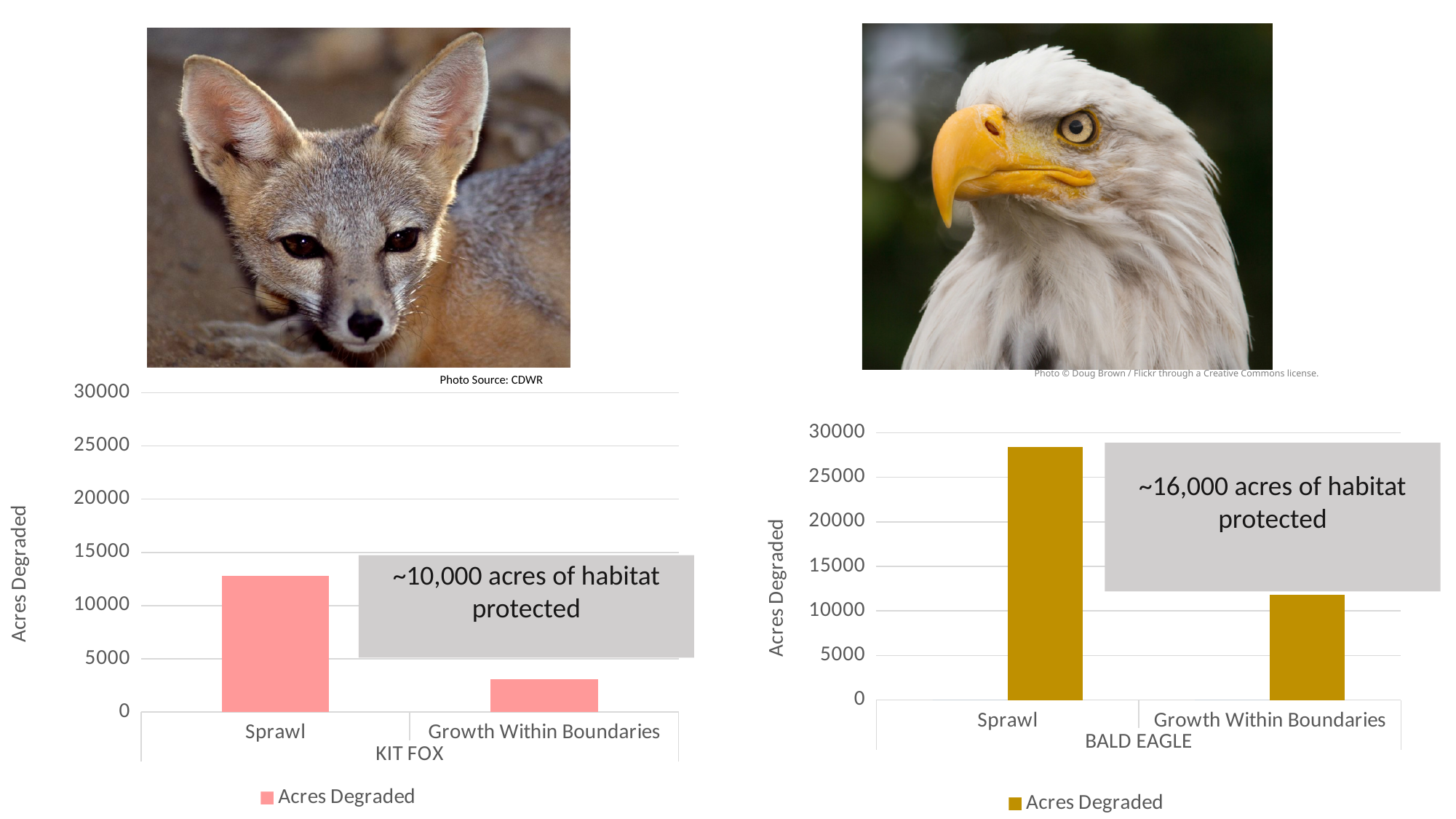
In the BALD EAGLE chart, is the value for Growth Within Boundaries greater or less than 15000? less In the KIT FOX chart, which category has the higher value for Acres Degraded? Sprawl In the BALD EAGLE chart, which category has the higher value for Acres Degraded? Sprawl In the KIT FOX chart, which category has the lower value for Acres Degraded? Growth Within Boundaries How many series does the legend of the BALD EAGLE chart list? 1 In the KIT FOX chart, is the value for Sprawl greater or less than 10000? greater In the KIT FOX chart, how many categories are shown on the x axis? 2 In the BALD EAGLE chart, is the value for Sprawl greater or less than 25000? greater What is the y-axis title of the BALD EAGLE chart? Acres Degraded What kind of chart is the KIT FOX chart? bar chart What does the text box on the KIT FOX chart say? ~10,000 acres of habitat protected